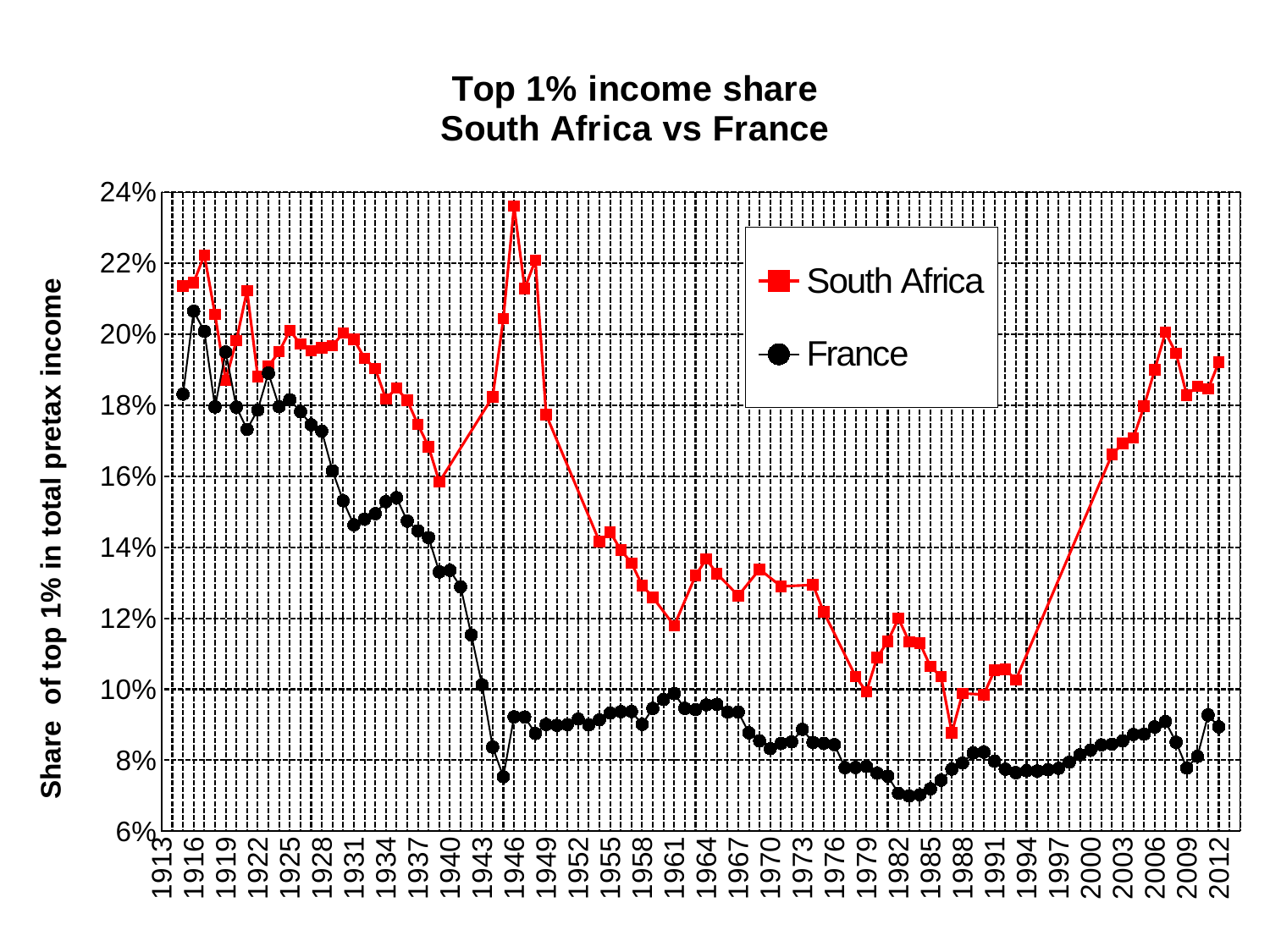
Does the France series rise or fall between 1913 and 1943? fall What kind of chart is shown on the slide? line chart Which series is drawn with red square markers? South Africa Is the value for France in 1982 greater or less than 8%? less How many series does the legend list? 2 Is the value for South Africa in 2006 greater or less than 18%? greater In which year does the South Africa series reach its highest value? 1946 Is the value for France in 1946 greater or less than 10%? less Which series has the larger value in 1982, South Africa or France? South Africa What is the title of the chart? Top 1% income share South Africa vs France